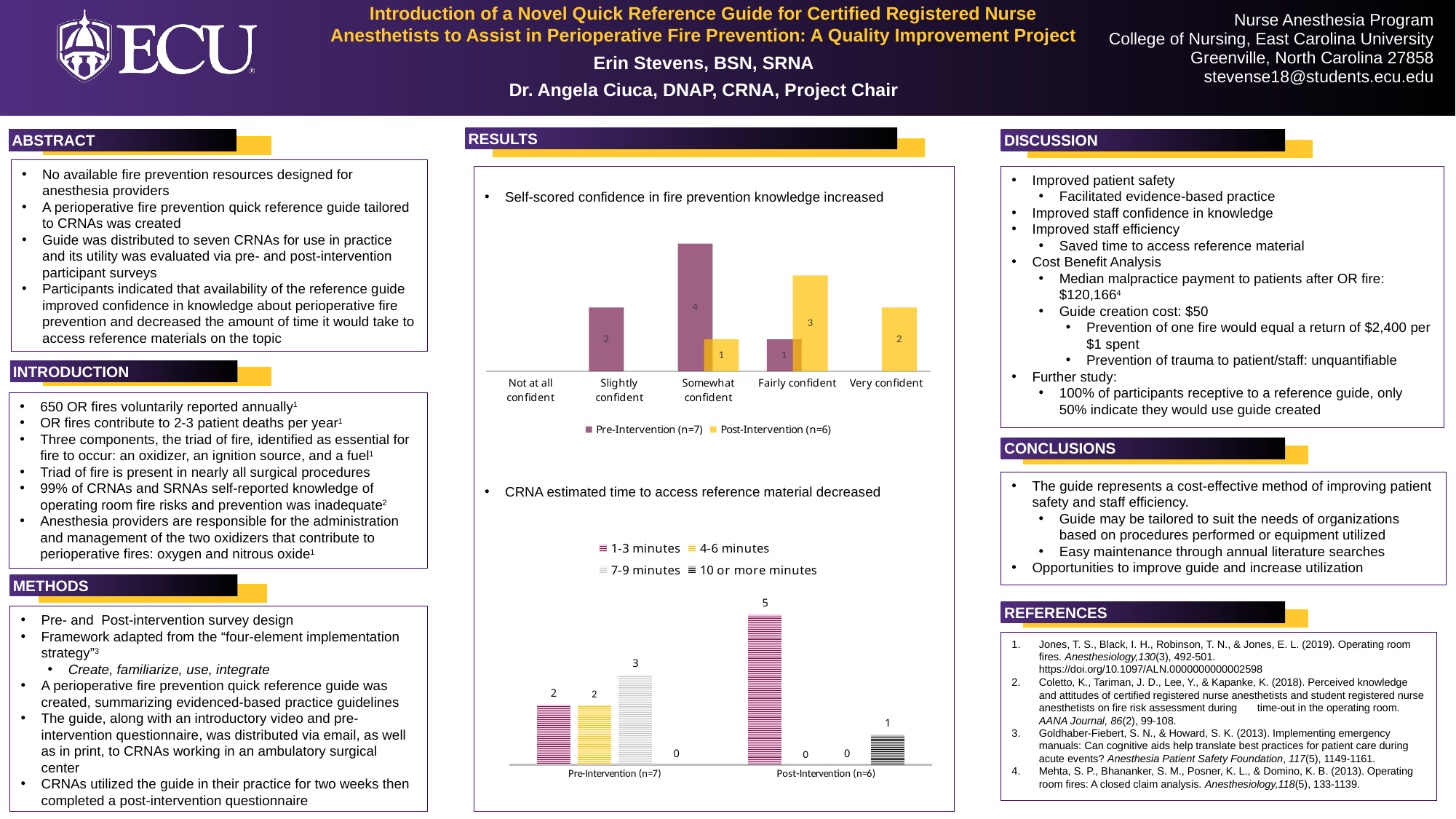
In the top chart on self-scored confidence, how many pre-intervention participants were 'Somewhat confident'? 4 What type of chart is the bottom chart on time to access reference material? Bar chart In the bottom chart on time to access reference material, how many pre-intervention participants reported '7-9 minutes'? 3 In the top chart on self-scored confidence, which category has the highest pre-intervention value? Somewhat confident In the top chart on self-scored confidence, how many confidence categories are shown on the x axis? 5 In the top chart on self-scored confidence, how many post-intervention participants were 'Very confident'? 2 In the bottom chart on time to access reference material, how many post-intervention participants reported '1-3 minutes'? 5 In the top chart on self-scored confidence, what is the difference between the pre-intervention and post-intervention values for 'Somewhat confident'? 3 In the top chart on self-scored confidence, how many series does the legend list? 2 In the top chart on self-scored confidence, how many post-intervention participants were 'Fairly confident'? 3 In the bottom chart on time to access reference material, which time range has the highest pre-intervention value? 7-9 minutes In the bottom chart on time to access reference material, how many series does the legend list? 4